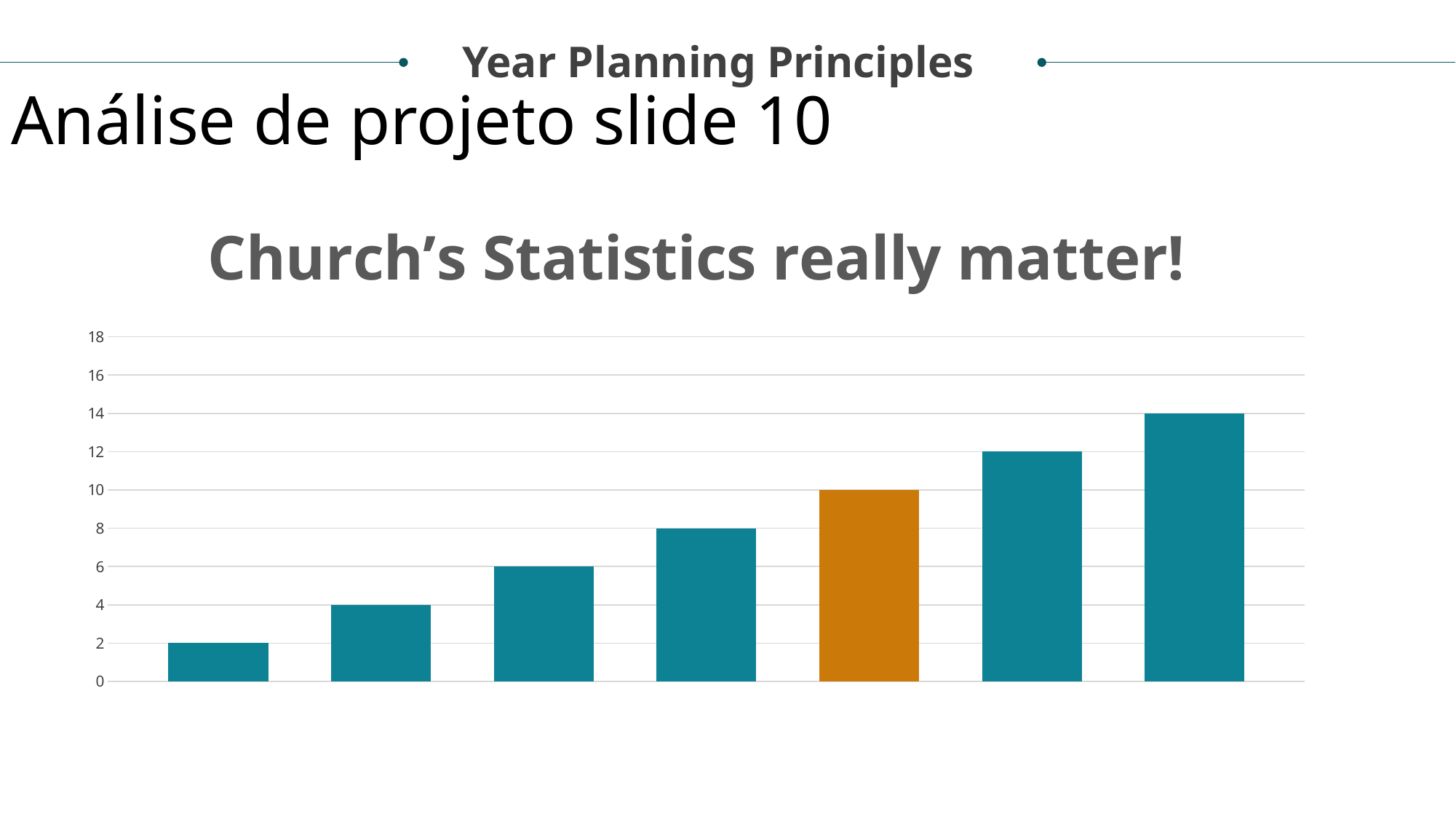
What is the value of the orange bar? 10 Which is larger, the orange bar or the bar immediately to its left? the orange bar What is the value of the last (rightmost) bar? 14 What is the difference between the rightmost bar and the leftmost bar? 12 Which bar has the lowest value? the leftmost bar Which bar has the highest value? the rightmost bar How many bars does the chart contain? 7 What is the value of the first (leftmost) bar? 2 What is the title shown above the chart? Church's Statistics really matter! What is the value of the fourth bar from the left? 8 What type of chart is shown on the slide? bar chart Do the bar values rise or fall from left to right? rise